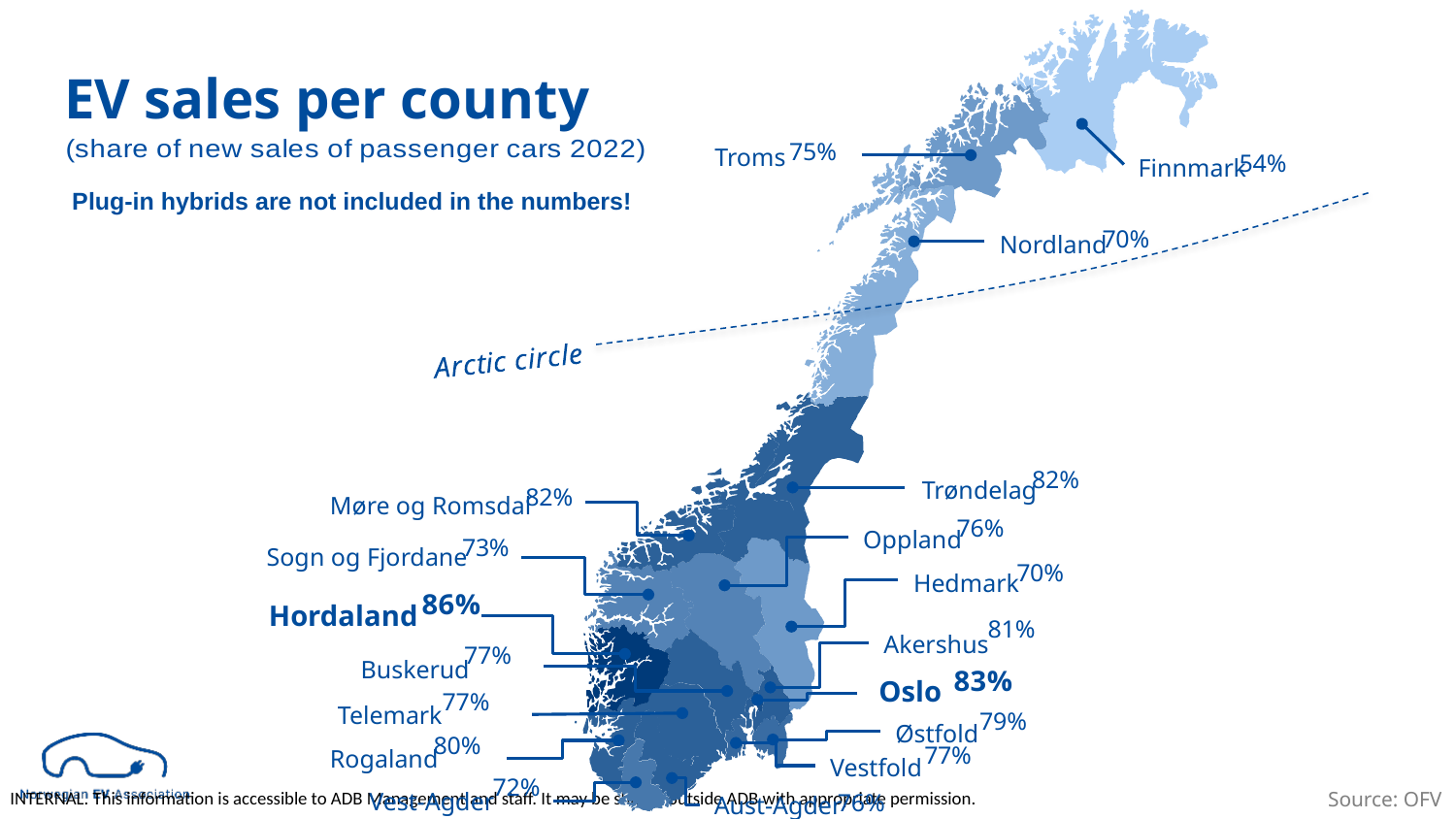
What is the difference in EV sales share between Hordaland and Finnmark? 32 percentage points How many counties are labelled with an EV sales share on the map? 18 What is the EV sales share for Hordaland? 86% What kind of chart is shown on the slide? Map chart What is the EV sales share for Sogn og Fjordane? 73% What is the title of the chart? EV sales per county Which county has the lowest EV sales share? Finnmark Which has a higher EV sales share, Rogaland or Vest-Agder? Rogaland Which has a higher EV sales share, Oslo or Akershus? Oslo What is the EV sales share for Finnmark? 54% Which county has the highest EV sales share? Hordaland What is the EV sales share for Oslo? 83%